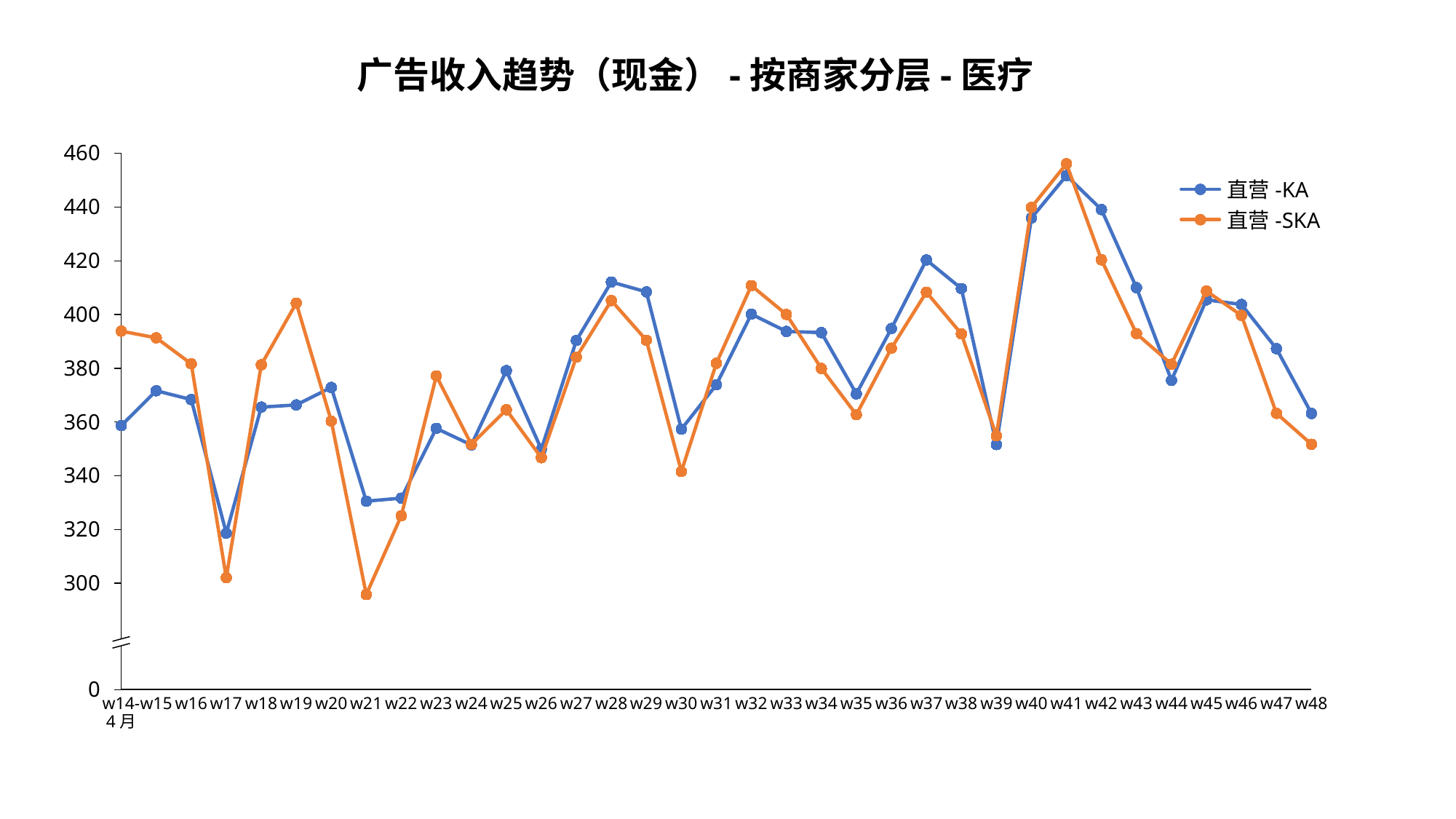
In which week does the 直营-SKA series reach its lowest value? w21 How many weeks are plotted along the x axis? 35 Does the 直营-KA series rise or fall from w41 to w44? fall At w19, which series has the larger value, 直营-KA or 直营-SKA? 直营-SKA What kind of chart is shown on the slide? line chart Is the value for 直营-SKA at w41 greater or less than 440? greater In which week does the 直营-KA series reach its lowest value? w17 Is the value for 直营-KA at w21 greater or less than 340? less How many series does the legend list? 2 In which week does the 直营-KA series reach its highest value? w41 In which week does the 直营-SKA series reach its highest value? w41 What is the title of the chart? 广告收入趋势（现金） - 按商家分层 - 医疗